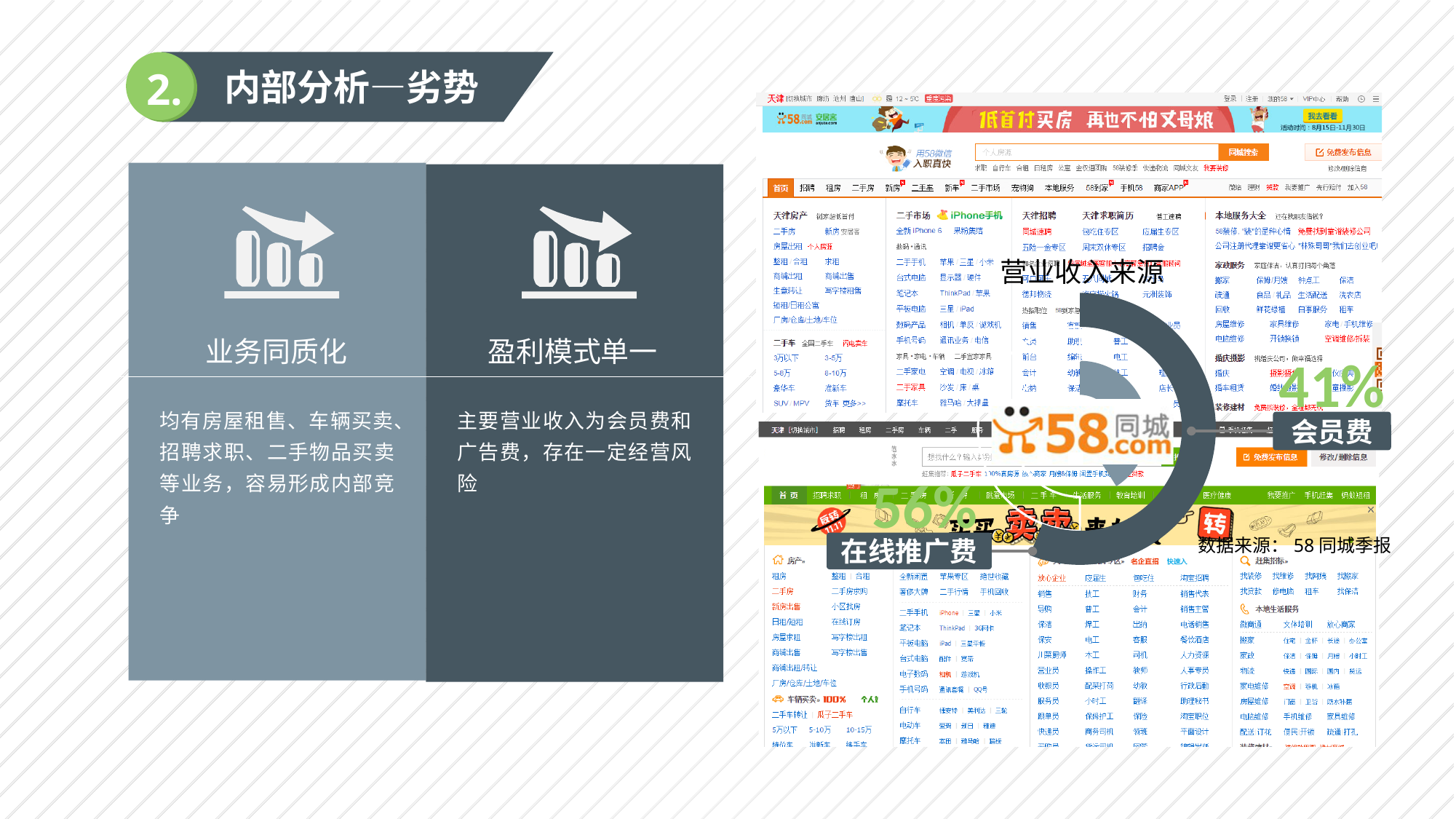
In the 营业收入来源 chart, by how many percentage points does 在线推广费 exceed 会员费? 15 percentage points What data source is cited for the 营业收入来源 chart? 58同城季报 In the 营业收入来源 chart, what share does 会员费 account for? 41% What is the title of the chart on the right side of the slide? 营业收入来源 What kind of chart is the 营业收入来源 chart? donut chart In the 营业收入来源 chart, what share does 在线推广费 account for? 56% Is the share for 在线推广费 in the 营业收入来源 chart greater or less than 50%? greater In the 营业收入来源 chart, is the share for 会员费 larger or smaller than the share for 在线推广费? smaller In the 营业收入来源 chart, which labeled revenue source has the smaller share? 会员费 In the 营业收入来源 chart, which labeled revenue source has the larger share? 在线推广费 How many revenue sources are labeled with percentages in the 营业收入来源 chart? 2 Is the share for 会员费 in the 营业收入来源 chart greater or less than 50%? less